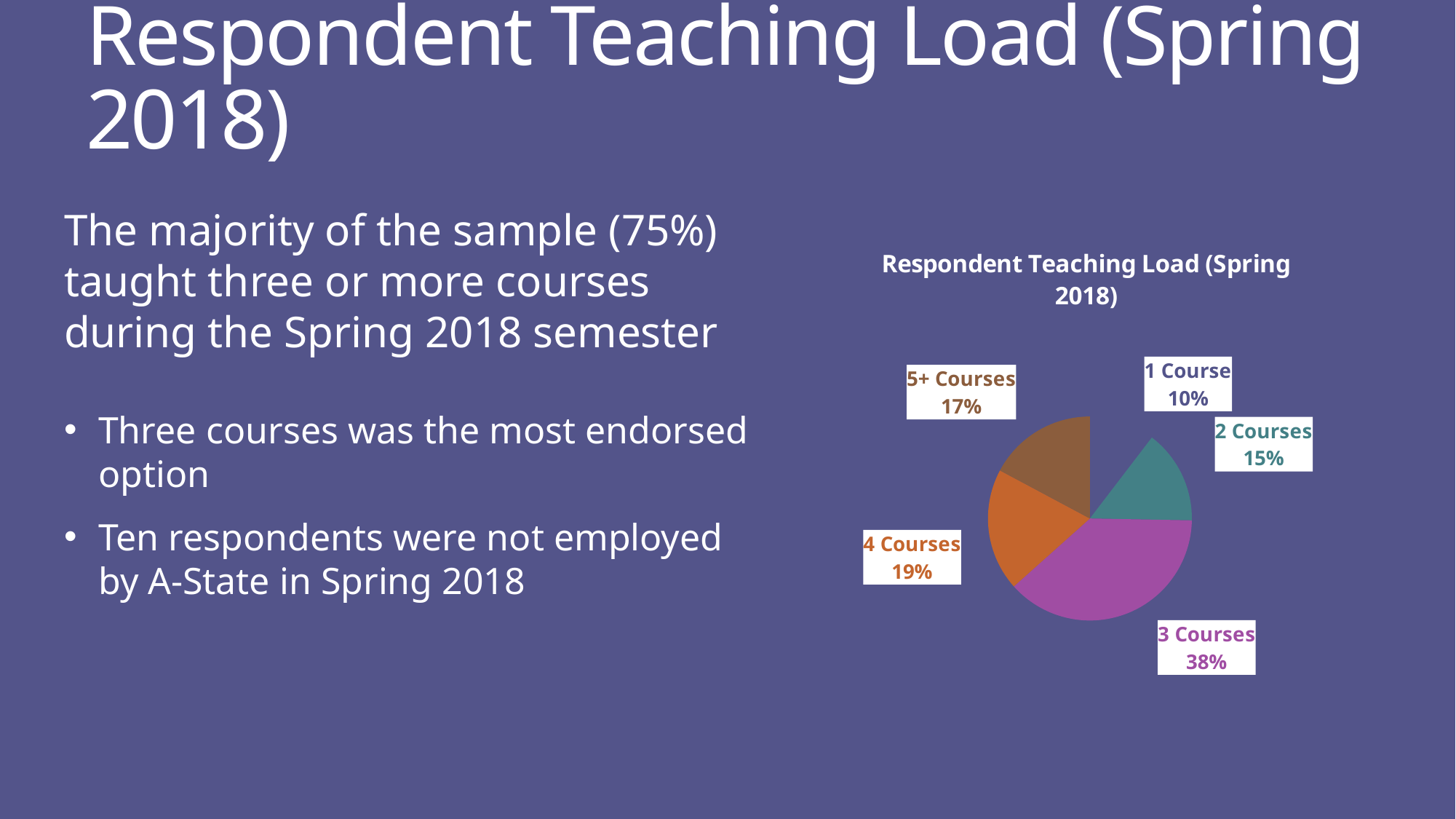
Which is larger, the share for 4 Courses or the share for 5+ Courses? 4 Courses What is the difference in percentage points between 3 Courses and 2 Courses? 23 Which category has the smallest share of the pie? 1 Course What percentage of respondents taught 1 Course? 10% What is the combined percentage for 1 Course and 2 Courses? 25% What share of the pie is labelled 5+ Courses? 17% What percentage of respondents taught 3 Courses? 38% How many categories are shown in the pie chart? 5 What is the title of the chart? Respondent Teaching Load (Spring 2018) Which category has the largest share of the pie? 3 Courses What percentage is shown for 4 Courses? 19% What type of chart is shown on the slide? Pie chart